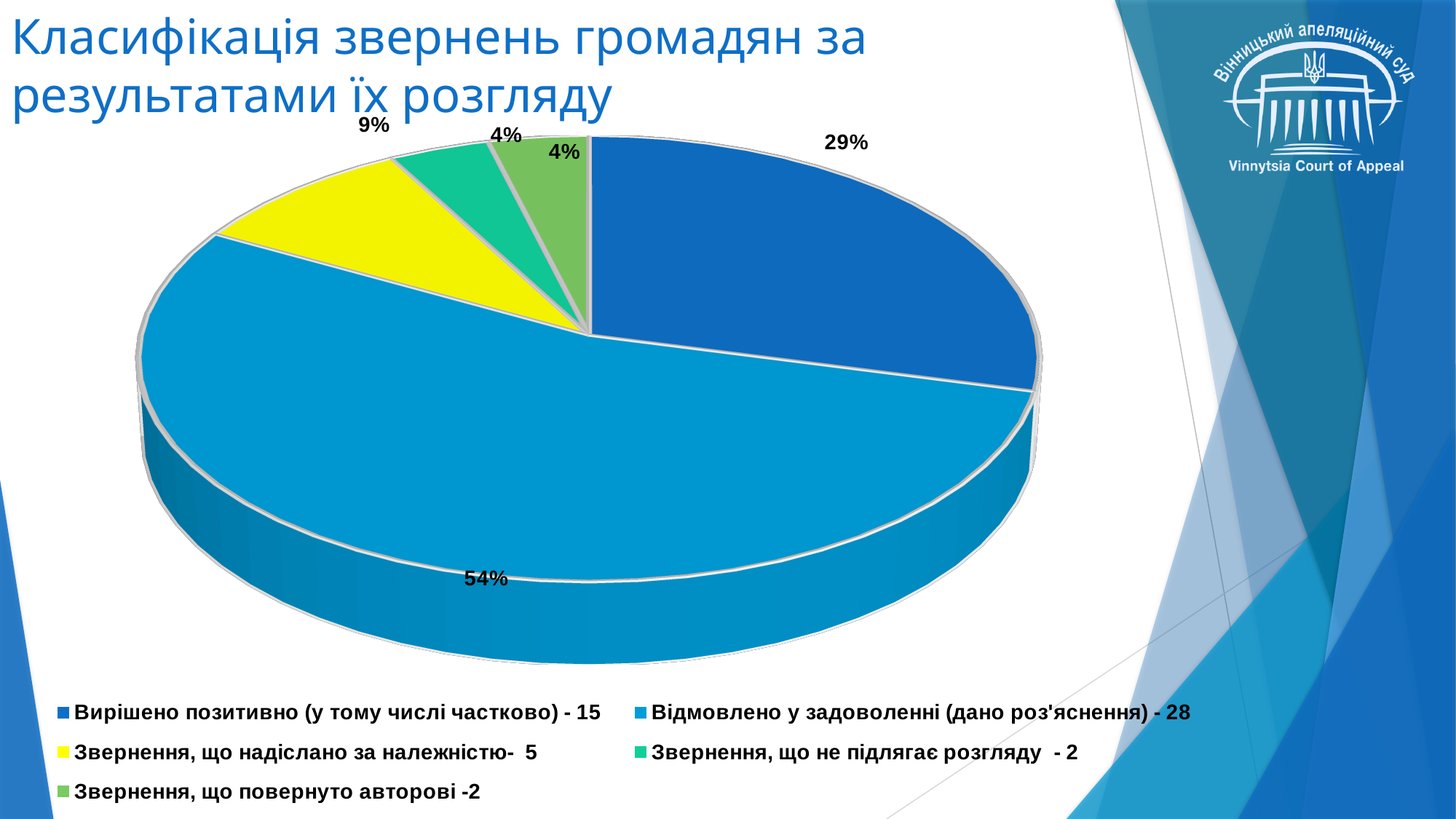
How many entries does the legend list? 5 According to the legend, how many appeals are in the category "Відмовлено у задоволенні (дано роз'яснення)"? 28 What percentage share does the slice "Вирішено позитивно (у тому числі частково)" have? 29% Which category has the largest slice of the pie? Відмовлено у задоволенні (дано роз'яснення) What kind of chart is shown on the slide? pie chart What colour is the slice for "Звернення, що надіслано за належністю"? yellow What percentage share does the slice "Звернення, що надіслано за належністю" have? 9% What percentage share does the slice "Відмовлено у задоволенні (дано роз'яснення)" have? 54% How many slices does the pie chart have? 5 What is the difference in percentage points between the "Відмовлено у задоволенні" slice and the "Вирішено позитивно" slice? 25 Which slice is larger: "Звернення, що надіслано за належністю" or "Звернення, що не підлягає розгляду"? Звернення, що надіслано за належністю